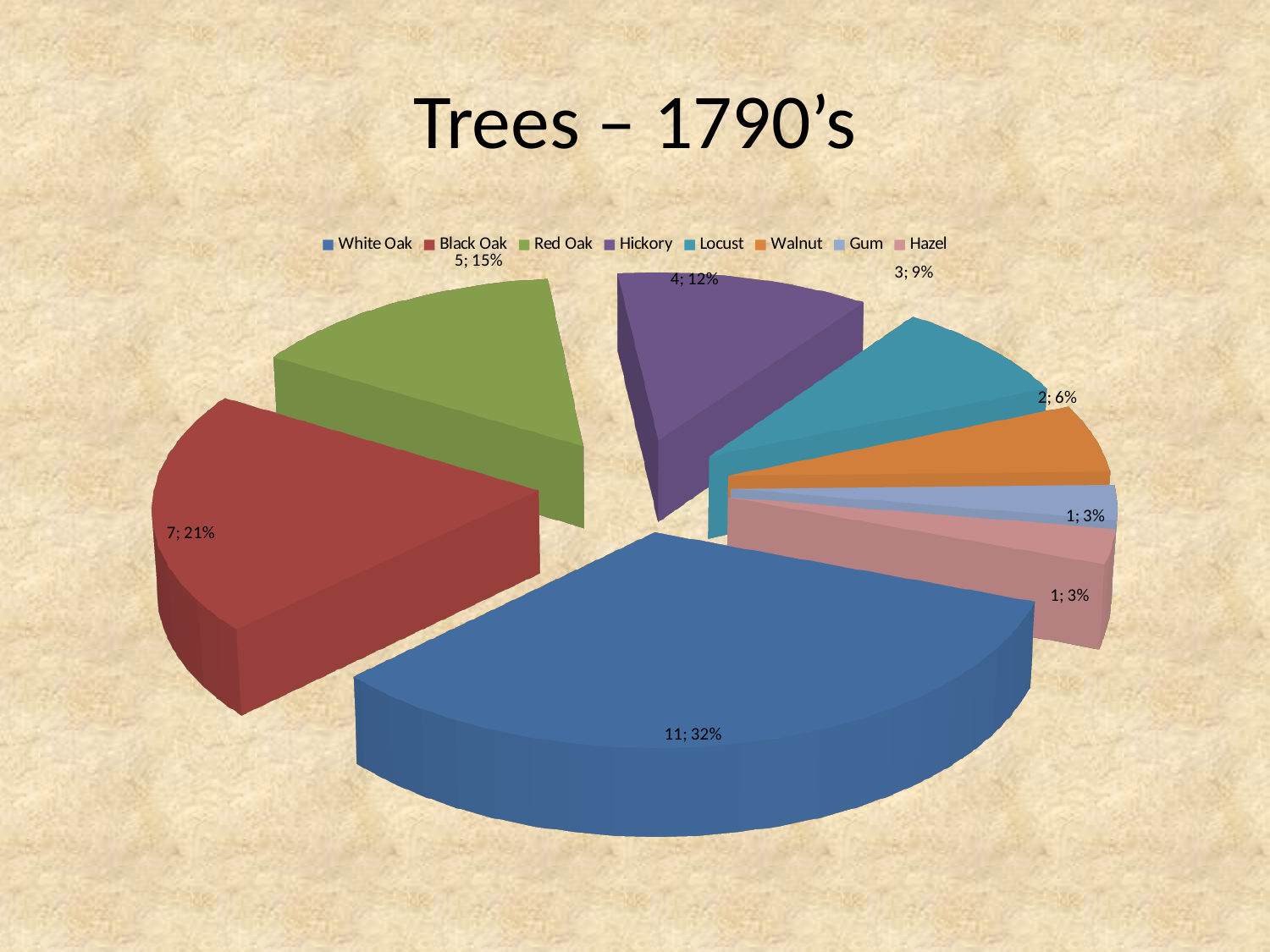
What value is shown for Black Oak? 7 How many categories does the legend list? 8 What is the title of the chart? Trees – 1790's What kind of chart is shown on the slide? Pie chart What value is shown for Locust? 3 Which tree type has the largest slice? White Oak What percentage share of the pie does Hickory have? 12% What percentage share of the pie does White Oak have? 32% What is the difference between the values for White Oak and Black Oak? 4 What value is shown for White Oak? 11 What percentage share of the pie does Walnut have? 6% Which is larger, the value for Red Oak or the value for Locust? Red Oak